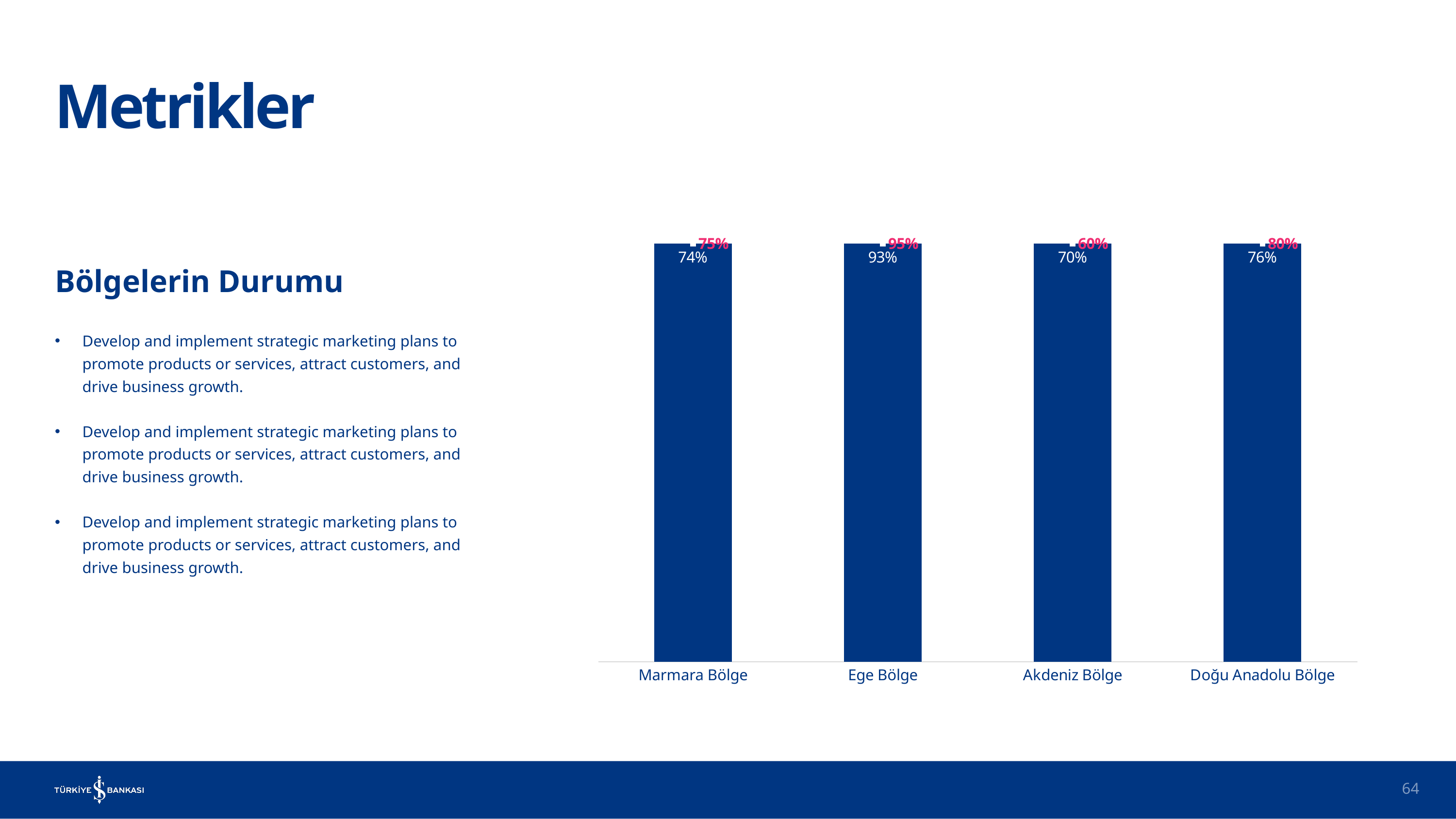
Which region has the highest white data label value? Ege Bölge What is the white data label shown on the Doğu Anadolu Bölge bar? 76% What is the white data label shown on the Ege Bölge bar? 93% How many regions are shown on the x axis of the chart? 4 Which has the larger white data label value, Doğu Anadolu Bölge or Akdeniz Bölge? Doğu Anadolu Bölge What kind of chart is shown on the slide? Bar chart What is the white data label shown on the Akdeniz Bölge bar? 70% What is the pink data label shown above the Ege Bölge bar? 95% Which region has the lowest white data label value? Akdeniz Bölge What is the white data label shown on the Marmara Bölge bar? 74% What is the pink data label shown above the Akdeniz Bölge bar? 60% What is the difference between the white data labels for Ege Bölge and Marmara Bölge? 19%